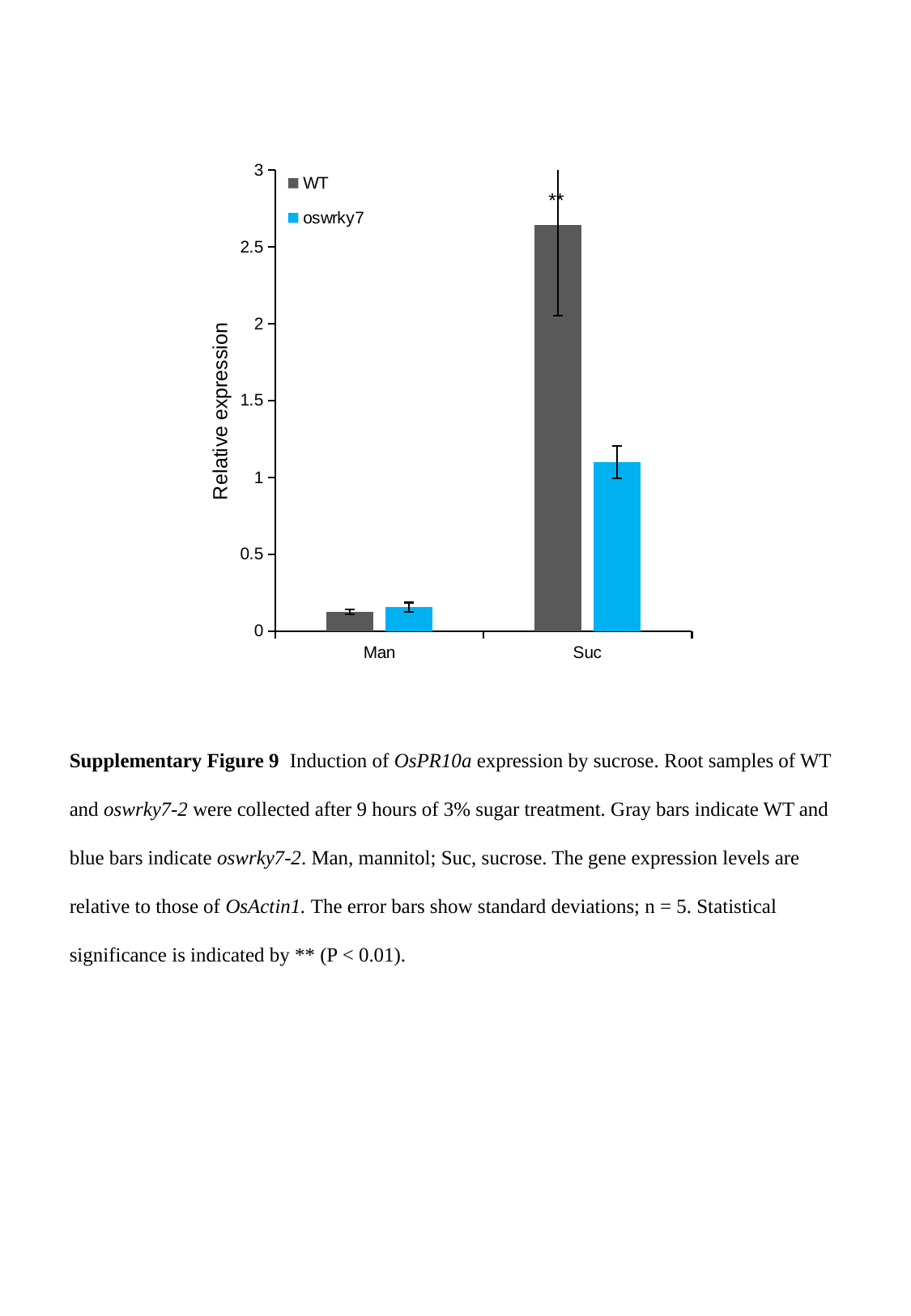
Which series and category has the highest bar? WT at Suc Is the value for WT at Suc greater or less than 2.5? greater For WT, is the value at Suc larger or smaller than the value at Man? larger What kind of chart is shown on the slide? bar chart Is the value for WT at Man greater or less than 0.5? less Is the value for oswrky7 at Man greater or less than 0.5? less What are the two entries in the legend? WT and oswrky7 At Suc, which series has the larger value, WT or oswrky7? WT What is the label of the y axis? Relative expression How many categories are shown on the x axis? 2 How many series does the legend list? 2